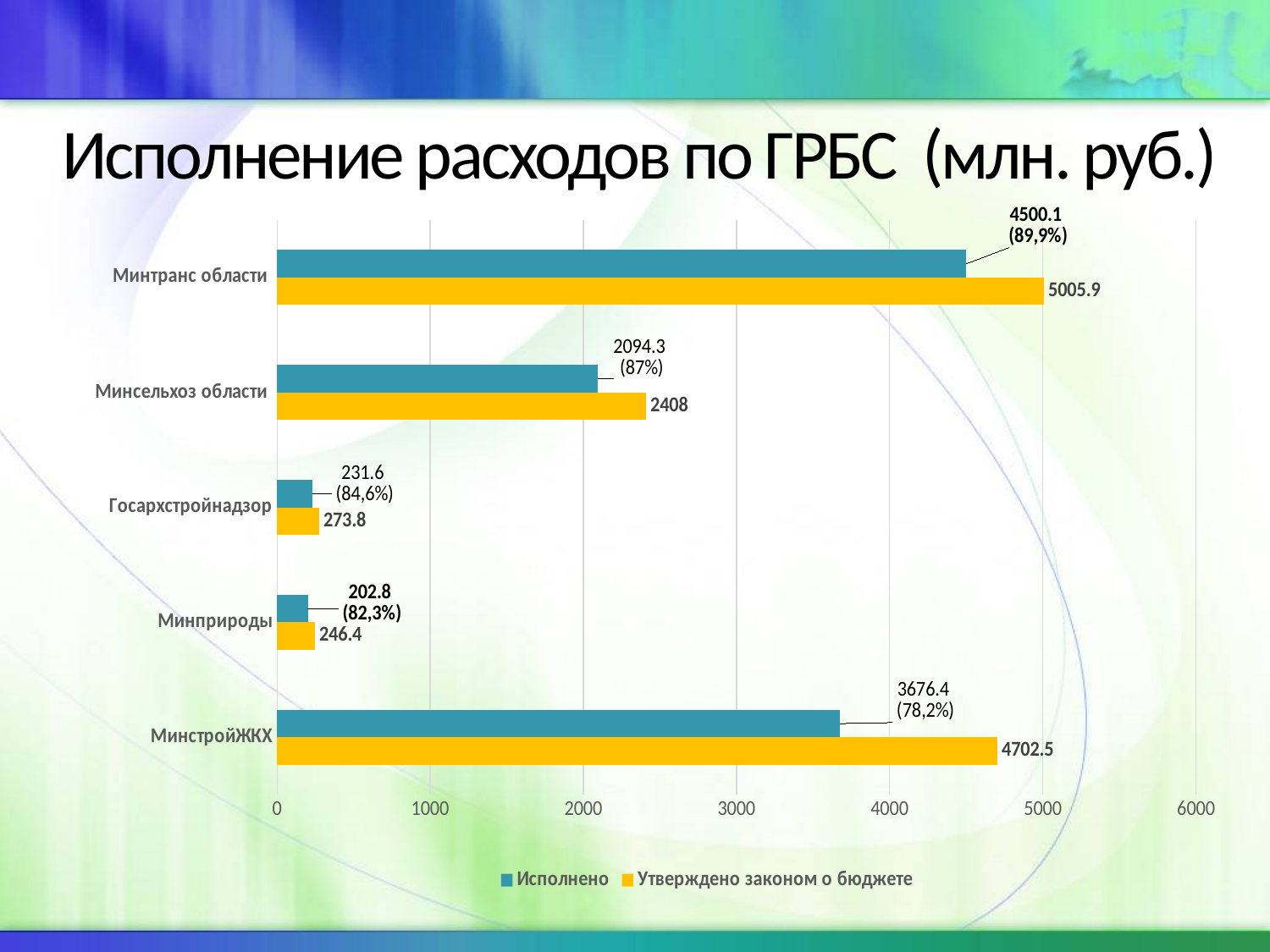
Which is larger: Исполнено for Минсельхоз области or Исполнено for МинстройЖКХ? Исполнено for МинстройЖКХ What is the title of the chart? Исполнение расходов по ГРБС (млн. руб.) What is the value of Исполнено for Минсельхоз области? 2094.3 How many categories are shown on the chart? 5 Which category has the lowest value of Исполнено? Минприроды What is the value of Утверждено законом о бюджете for Минприроды? 246.4 What is the value of Утверждено законом о бюджете for Минтранс области? 5005.9 What is the value of Исполнено for МинстройЖКХ? 3676.4 What is the difference between Утверждено законом о бюджете and Исполнено for Госархстройнадзор? 42.2 Which category has the highest value of Утверждено законом о бюджете? Минтранс области How many series does the legend list? 2 What type of chart is shown on the slide? bar chart